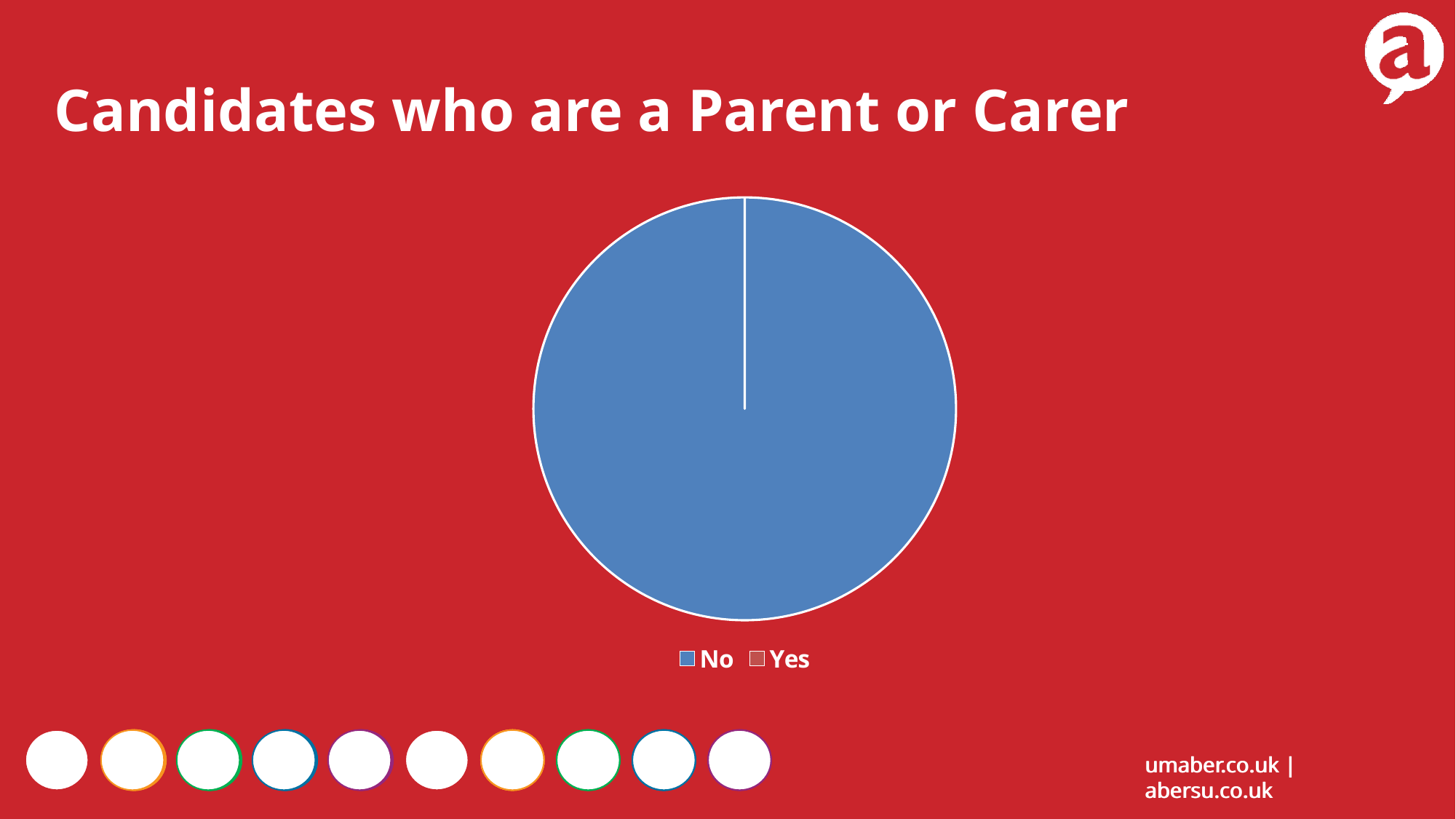
What kind of chart is shown on the slide? pie chart Which category takes up the largest share of the pie chart? No Which slice is larger in the pie chart, No or Yes? No What are the two categories listed in the chart legend? No and Yes How many categories does the legend of the pie chart list? 2 Which category takes up the smallest share of the pie chart? Yes What is the title of the chart? Candidates who are a Parent or Carer What colour represents the No category in the pie chart? blue